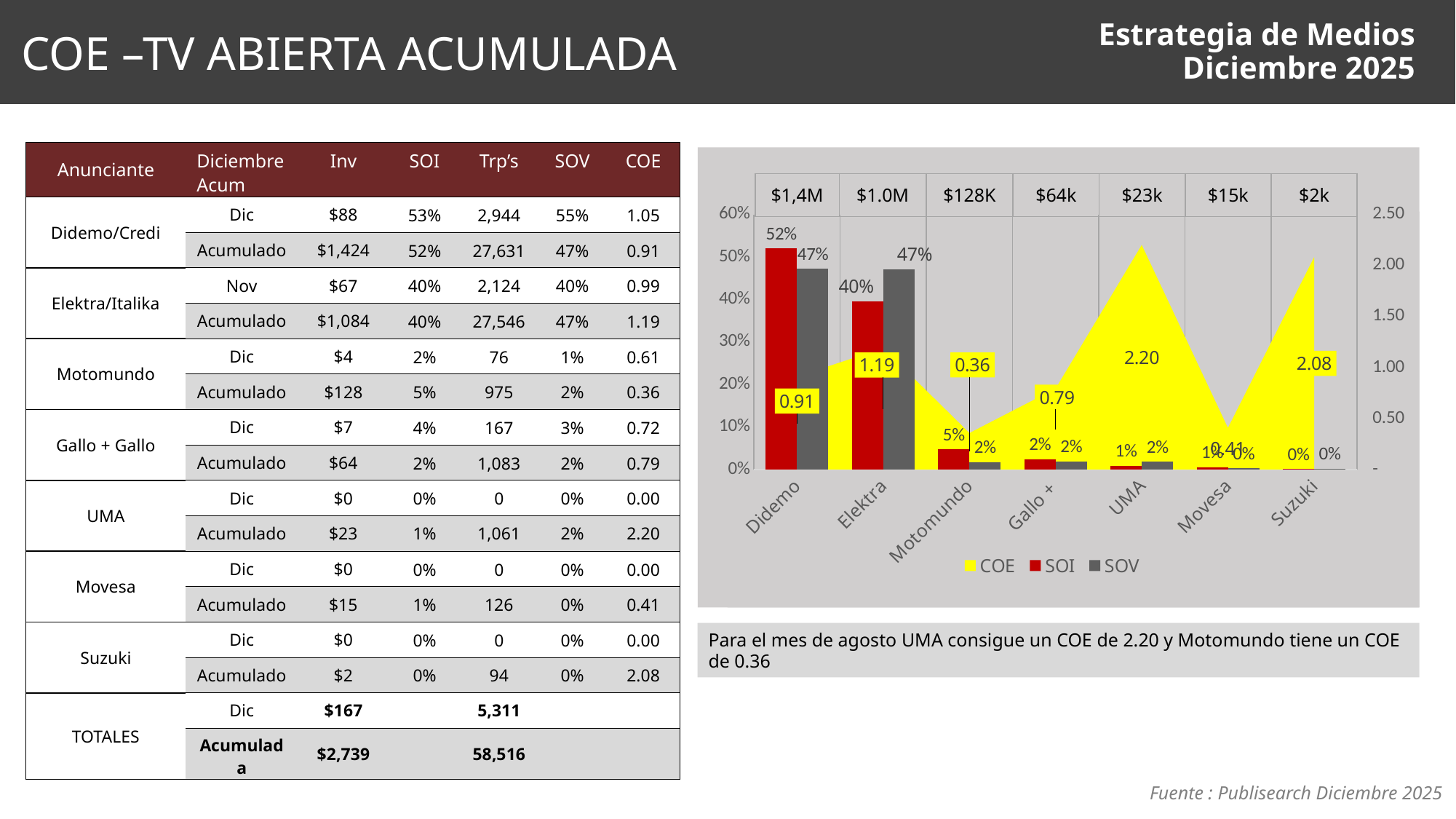
Is the SOV value for Didemo greater or less than 40%? greater Which is larger in the chart, the COE for Elektra or the COE for Gallo +? Elektra Which category has the highest COE value in the chart? UMA What is the COE value for Motomundo in the chart? 0.36 Which category has the highest SOI value in the chart? Didemo What is the SOV value for Elektra in the chart? 47% How many categories are shown on the x axis of the chart? 7 What is the COE value for UMA in the chart? 2.20 Which series in the chart is shown in yellow? COE How many series does the chart legend list? 3 What is the SOI value for Didemo in the chart? 52% What is the difference between the SOI values for Didemo and Elektra in the chart? 12%